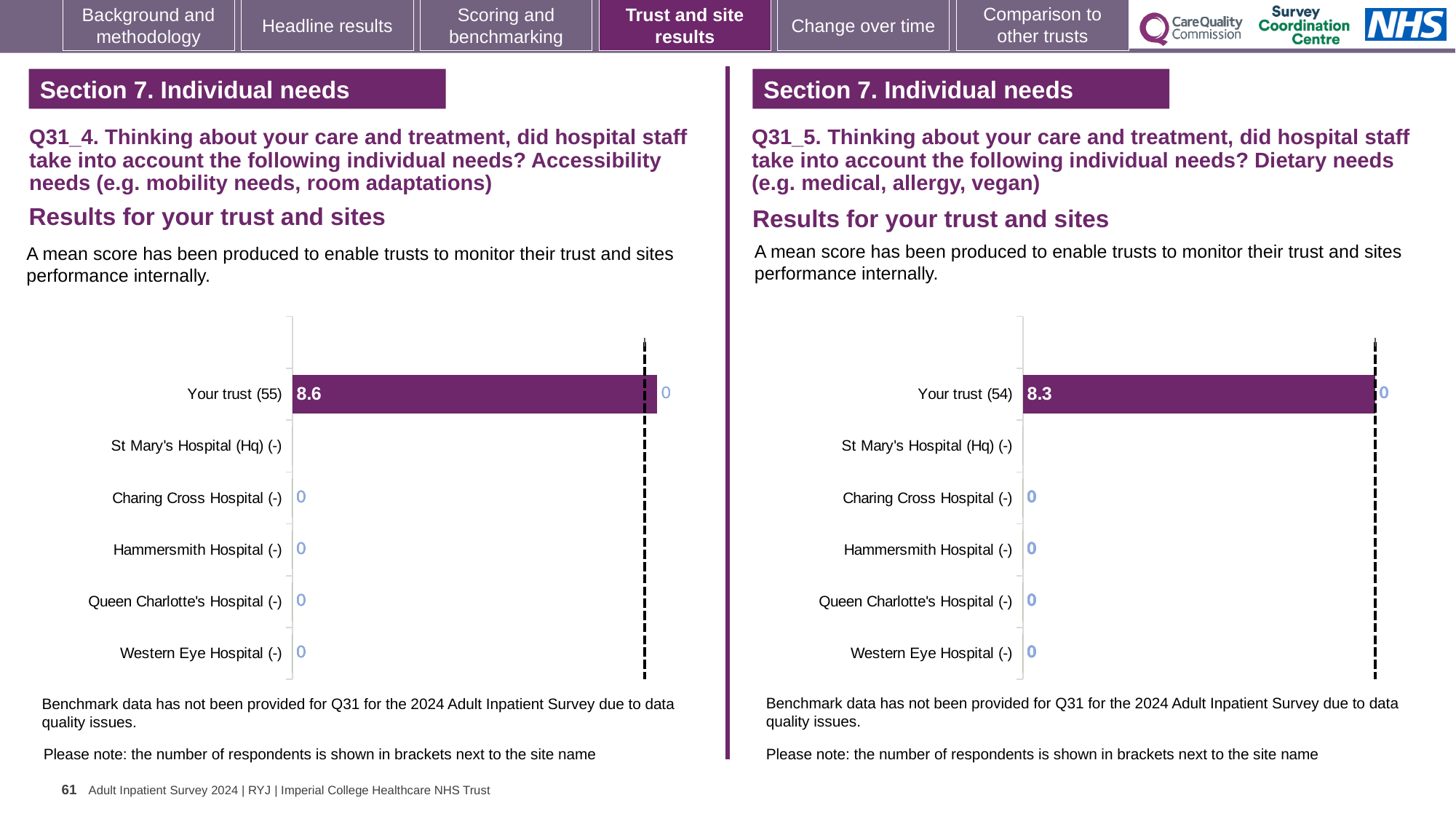
Which is larger: the Your trust score in the Q31_4 chart on the left or the Your trust score in the Q31_5 chart on the right? Q31_4 (left) What type of chart is used in the Q31_4 chart on the left? Bar chart How many site categories are listed on the y axis of the Q31_4 chart on the left? 6 In the Q31_5 chart on the right, how many respondents are shown in brackets next to Your trust? 54 In the Q31_4 chart (Accessibility needs) on the left, what is the mean score for Your trust? 8.6 In the Q31_4 chart on the left, how many respondents are shown in brackets next to Your trust? 55 How many site categories are listed on the y axis of the Q31_5 chart on the right? 6 In the Q31_5 chart on the right, which category has the highest score? Your trust (54) What is the difference between the Your trust score in the Q31_4 chart on the left and the Your trust score in the Q31_5 chart on the right? 0.3 In the Q31_5 chart (Dietary needs) on the right, what is the mean score for Your trust? 8.3 In the Q31_4 chart on the left, which category has the highest score? Your trust (55)